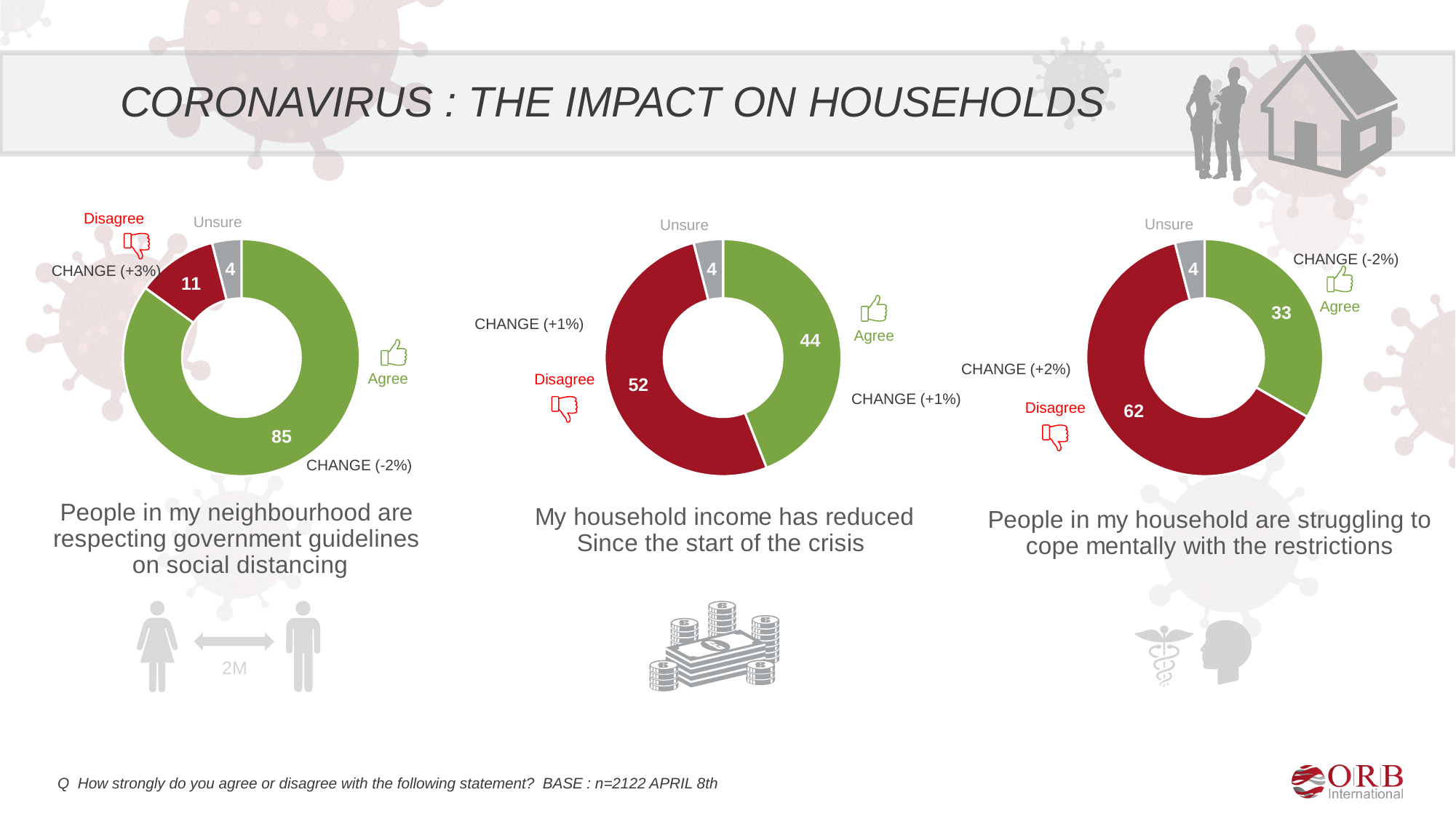
In the middle chart (My household income has reduced since the start of the crisis), what is the value for Agree? 44 How many categories does each doughnut chart on the slide show? 3 In the right chart (People in my household are struggling to cope mentally with the restrictions), what is the value for Unsure? 4 In the left chart (People in my neighbourhood are respecting government guidelines on social distancing), which category has the largest share? Agree What kind of chart is used for each of the three statements on the slide? Doughnut chart In the right chart (People in my household are struggling to cope mentally with the restrictions), what is the value for Disagree? 62 In the middle chart (My household income has reduced since the start of the crisis), what is the difference between Disagree and Agree? 8 In the middle chart (My household income has reduced since the start of the crisis), what is the value for Disagree? 52 In the right chart (People in my household are struggling to cope mentally with the restrictions), which category has the smallest share? Unsure In the left chart (People in my neighbourhood are respecting government guidelines on social distancing), what is the value for Agree? 85 In the left chart (People in my neighbourhood are respecting government guidelines on social distancing), what is the value for Disagree? 11 In the right chart (People in my household are struggling to cope mentally with the restrictions), which is larger, Agree or Disagree? Disagree